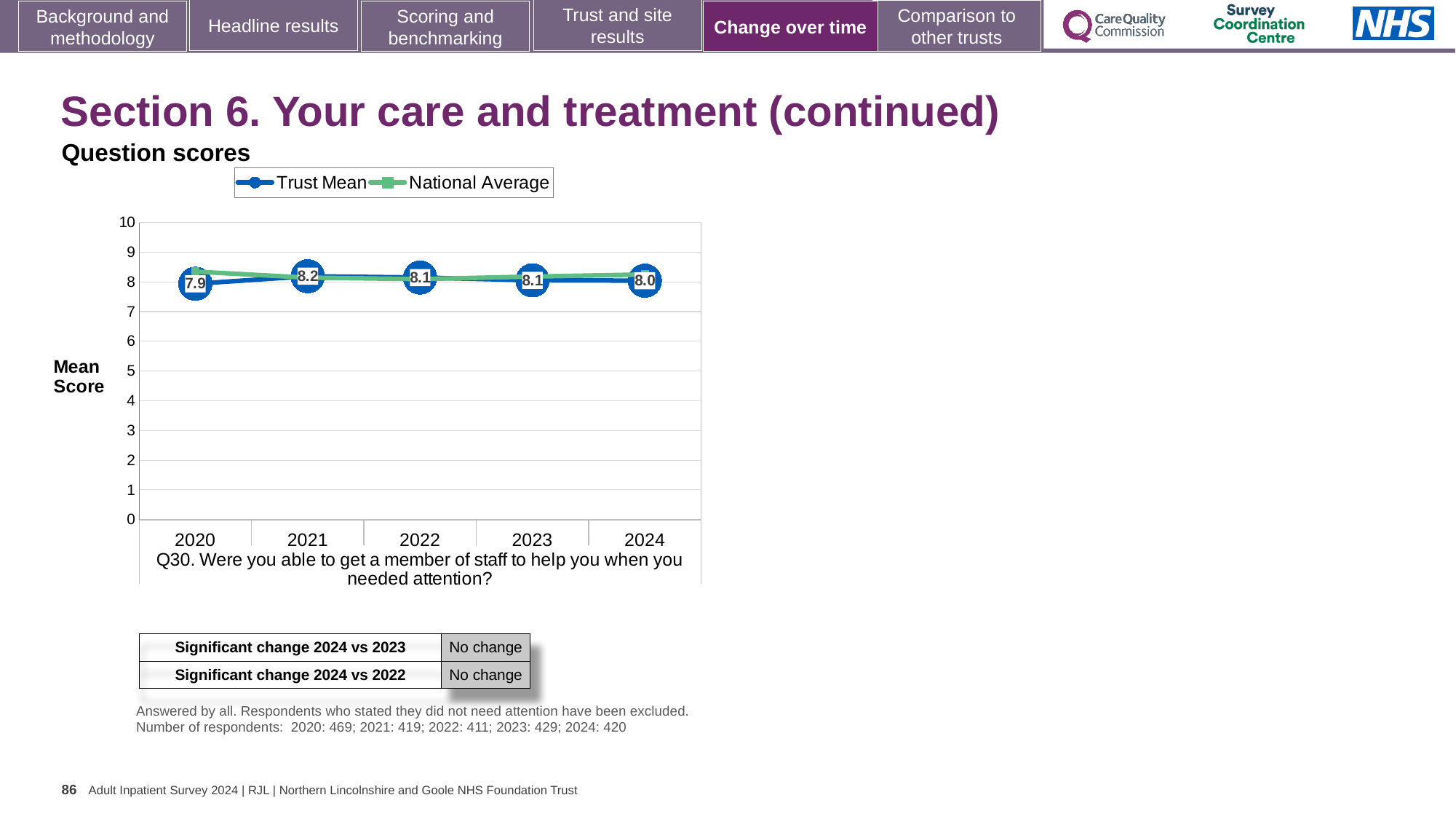
How many years are shown on the x axis of the chart? 5 Is the National Average value for 2020 greater or less than 7? greater What is the Trust Mean score for 2021? 8.2 What is the Trust Mean score for 2024? 8.0 How many series does the legend list? 2 In which year is the Trust Mean score highest? 2021 What is the difference between the Trust Mean scores for 2021 and 2020? 0.3 What is the Trust Mean score for 2020? 7.9 What kind of chart is shown on the slide? Line chart In which year is the Trust Mean score lowest? 2020 Which year has the larger Trust Mean score, 2020 or 2024? 2024 Does the Trust Mean score rise or fall from 2021 to 2024? Fall